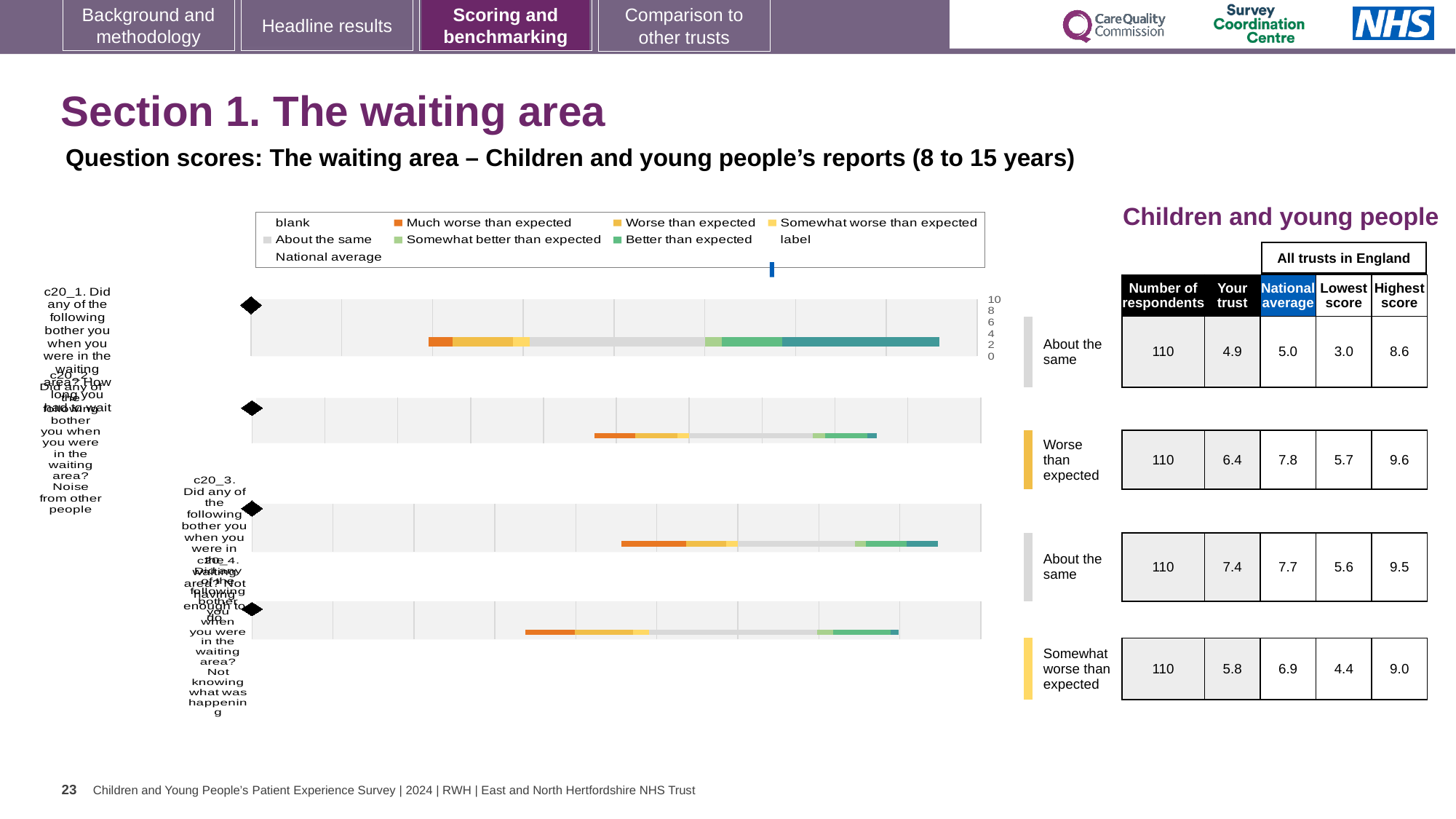
Which of the four questions has the highest 'Your trust' score in the table? the third question (7.4) In the chart legend, which colour represents 'Much worse than expected'? orange How many entries does the chart legend list? 9 In the table next to the charts, what is the national average for the second question (rated 'Worse than expected')? 7.8 In the table next to the charts, what is the 'Your trust' score for the first question (rated 'About the same')? 4.9 In the table next to the charts, what is the lowest score for the fourth question (rated 'Somewhat worse than expected')? 4.4 In the table next to the charts, what is the highest score for the third question (rated 'About the same')? 9.5 What kind of chart is used to show the question scores on this slide? bar chart How many respondents are listed for each of the four waiting area questions? 110 What is the difference between the national average and the 'Your trust' score for the second question (rated 'Worse than expected')? 1.4 How many separate bar charts (one per question) are shown on the slide? 4 What is the highest value shown on the chart's axis scale? 10